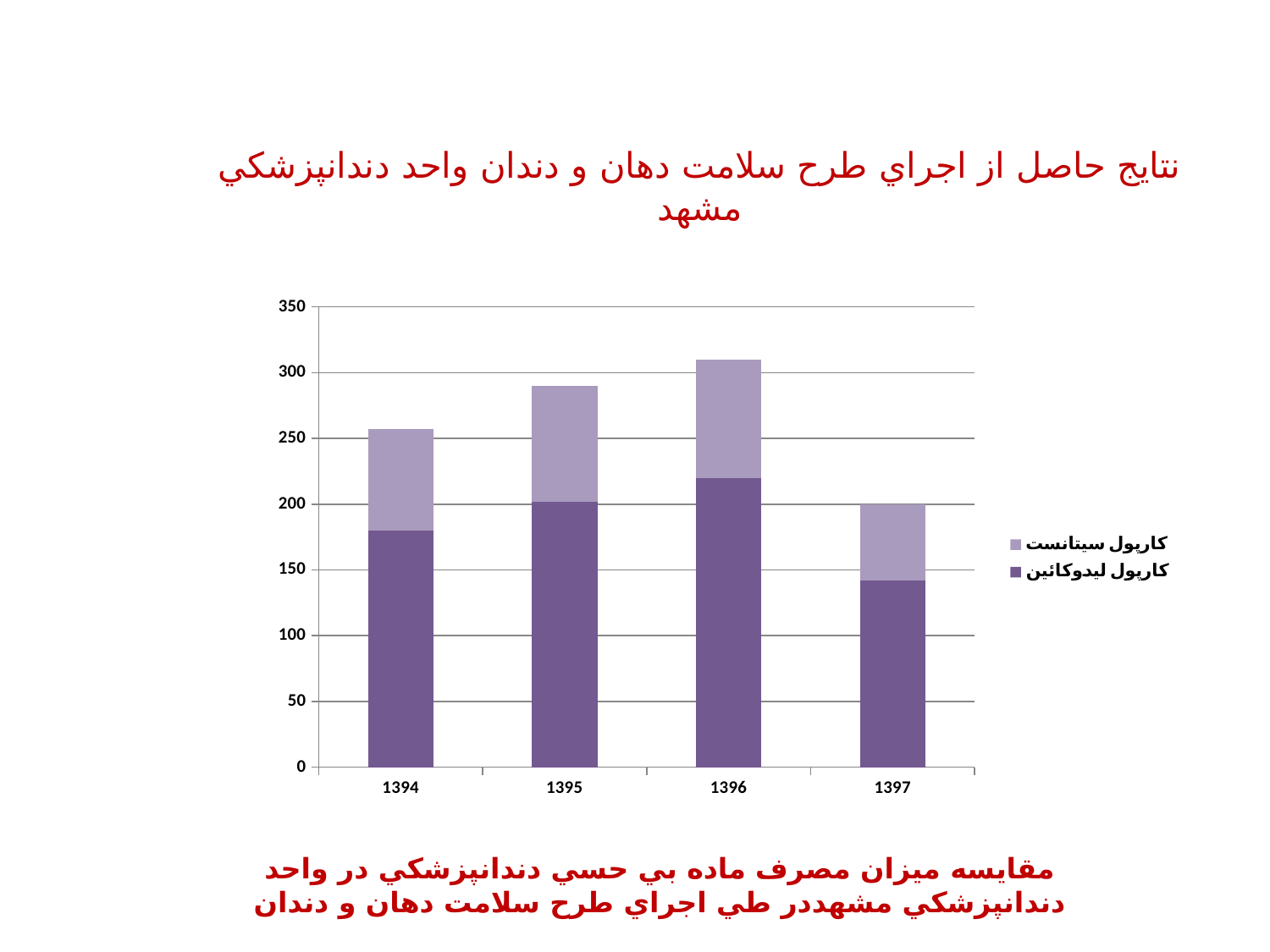
Which year has the shortest stacked bar (lowest total) in the chart? 1397 Is the total stacked bar for 1396 greater or less than 300? greater What kind of chart is shown on the slide? Stacked bar chart How many years (categories) are shown on the x axis of the chart? 4 How many series does the chart's legend list? 2 Which year has the tallest stacked bar (highest total) in the chart? 1396 Which year has the lowest value for کارپول لیدوکائین? 1397 Which year has the larger total stacked bar, 1394 or 1395? 1395 How do the total stacked bar values change from 1394 to 1397? They rise from 1394 to 1396, then fall in 1397 Which year has the highest value for کارپول لیدوکائین? 1396 Is the value for کارپول لیدوکائین in 1394 greater or less than 150? greater Is the value for کارپول لیدوکائین in 1397 greater or less than 150? less